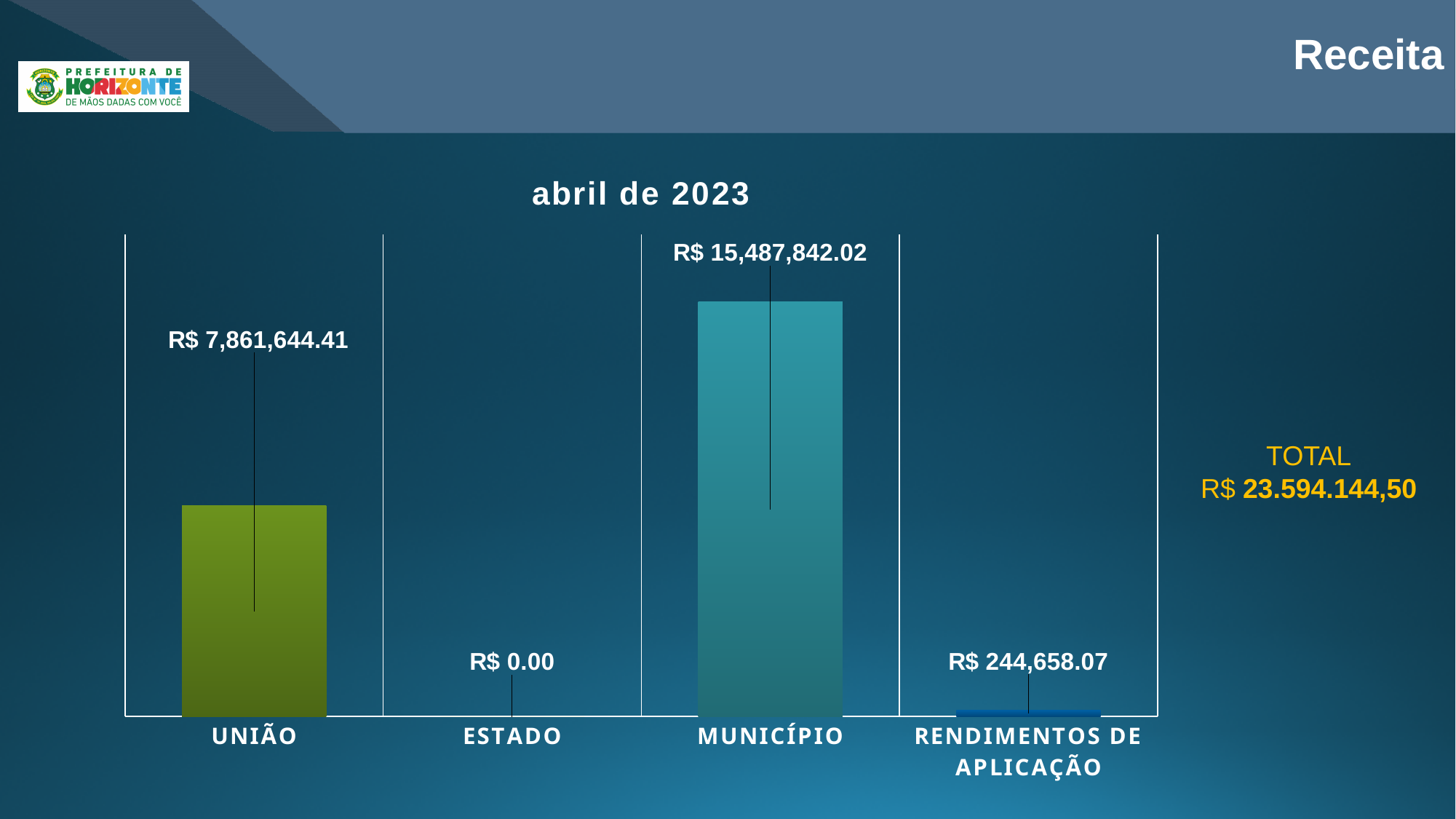
Which category has the lowest value? ESTADO How many categories are shown in the chart? 4 Which category has the highest value? MUNICÍPIO What is the difference between the values for MUNICÍPIO and UNIÃO? R$ 7,626,197.61 What is the value for UNIÃO? R$ 7,861,644.41 What is the value for RENDIMENTOS DE APLICAÇÃO? R$ 244,658.07 What kind of chart is shown on the slide? Bar chart What is the value for ESTADO? R$ 0.00 What is the difference between the values for UNIÃO and RENDIMENTOS DE APLICAÇÃO? R$ 7,616,986.34 Which is larger, the value for UNIÃO or the value for RENDIMENTOS DE APLICAÇÃO? UNIÃO What is the value for MUNICÍPIO? R$ 15,487,842.02 What is the title of the chart? abril de 2023